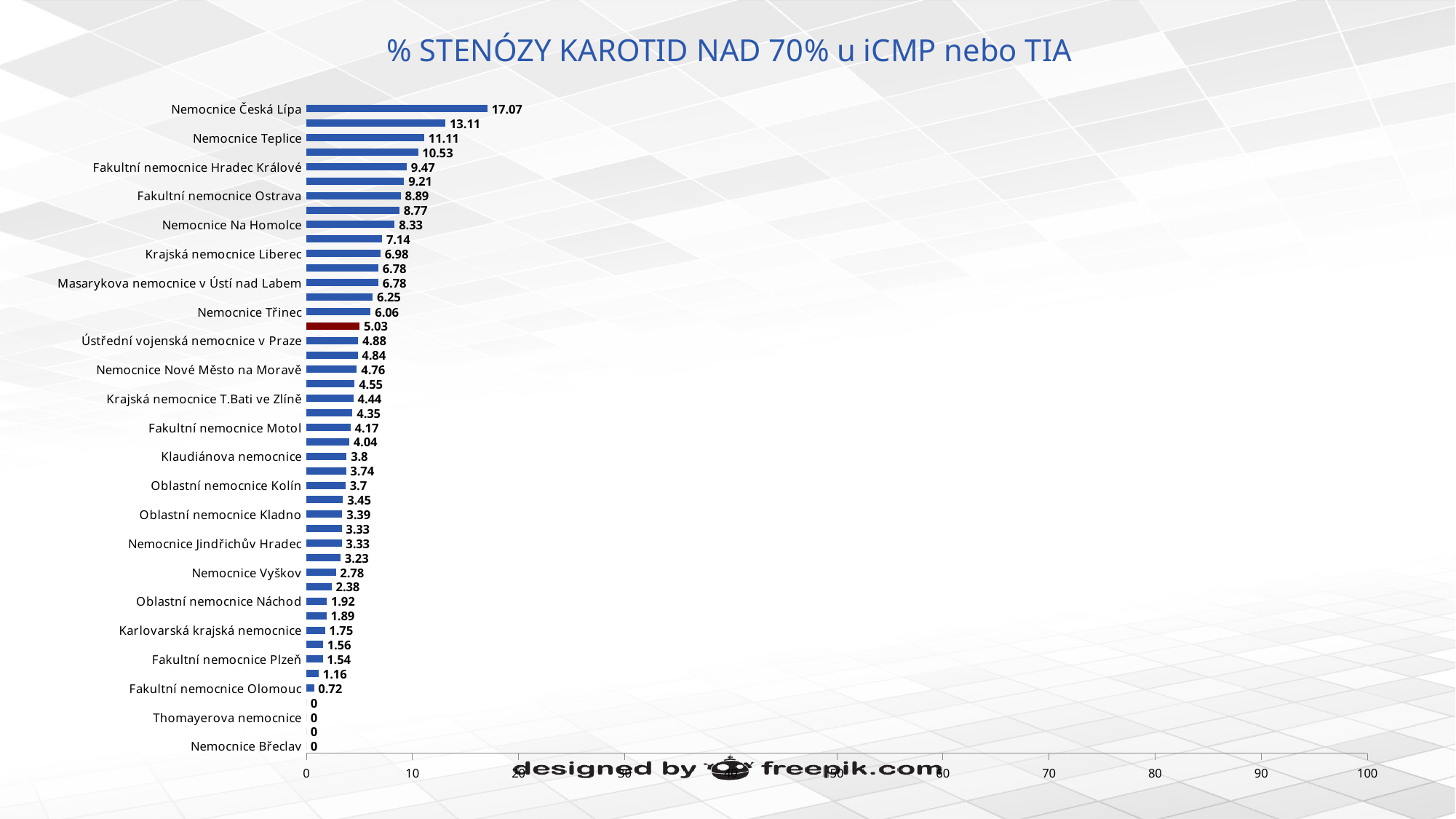
What is the difference between the values for Nemocnice Teplice and Nemocnice Na Homolce? 2.78 What is the value of the bar highlighted in dark red? 5.03 What is the value for Fakultní nemocnice Ostrava? 8.89 Is the value for Fakultní nemocnice Hradec Králové greater or less than 10? less What is the value for Nemocnice Třinec? 6.06 What is the lowest value shown in the chart? 0 What is the value for Nemocnice Česká Lípa? 17.07 Which is larger, the value for Krajská nemocnice Liberec or the value for Oblastní nemocnice Kolín? Krajská nemocnice Liberec Which hospital has the highest value? Nemocnice Česká Lípa What is the value for Fakultní nemocnice Motol? 4.17 What type of chart is shown on the slide? bar chart What is the value for Fakultní nemocnice Olomouc? 0.72